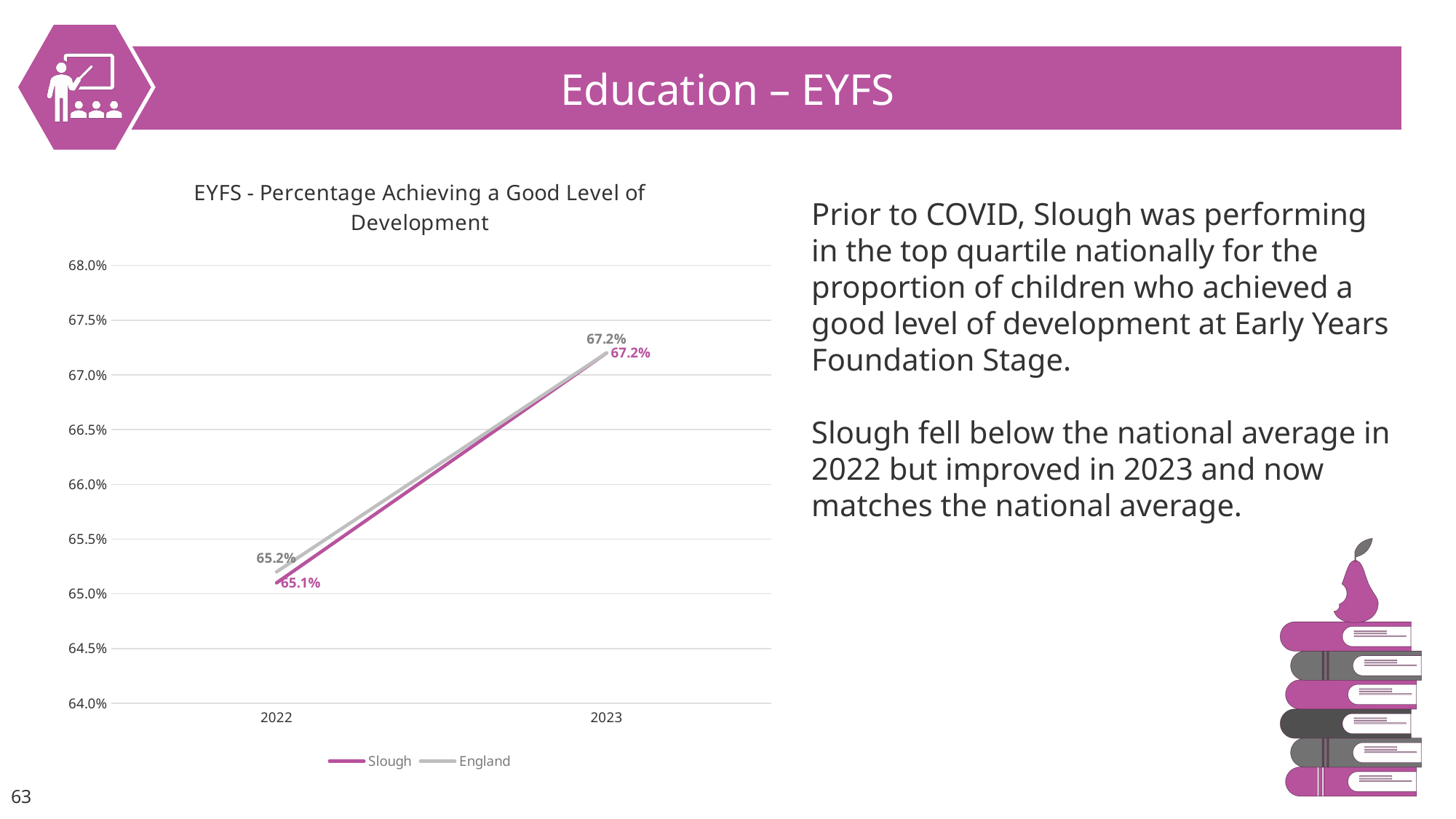
What is the value for Slough in 2022? 65.1% What is the difference between the Slough values for 2023 and 2022? 2.1% Does the Slough line rise or fall from 2022 to 2023? Rise Is the value for England in 2023 greater or less than 67.0%? greater What is the value for England in 2023? 67.2% How many series does the legend list? 2 What is the difference between the England and Slough values in 2022? 0.1% How many years are shown on the x axis? 2 What kind of chart is shown on the slide? Line chart Is the value for Slough in 2022 greater or less than 66.0%? less What is the value for England in 2022? 65.2% What is the value for Slough in 2023? 67.2%